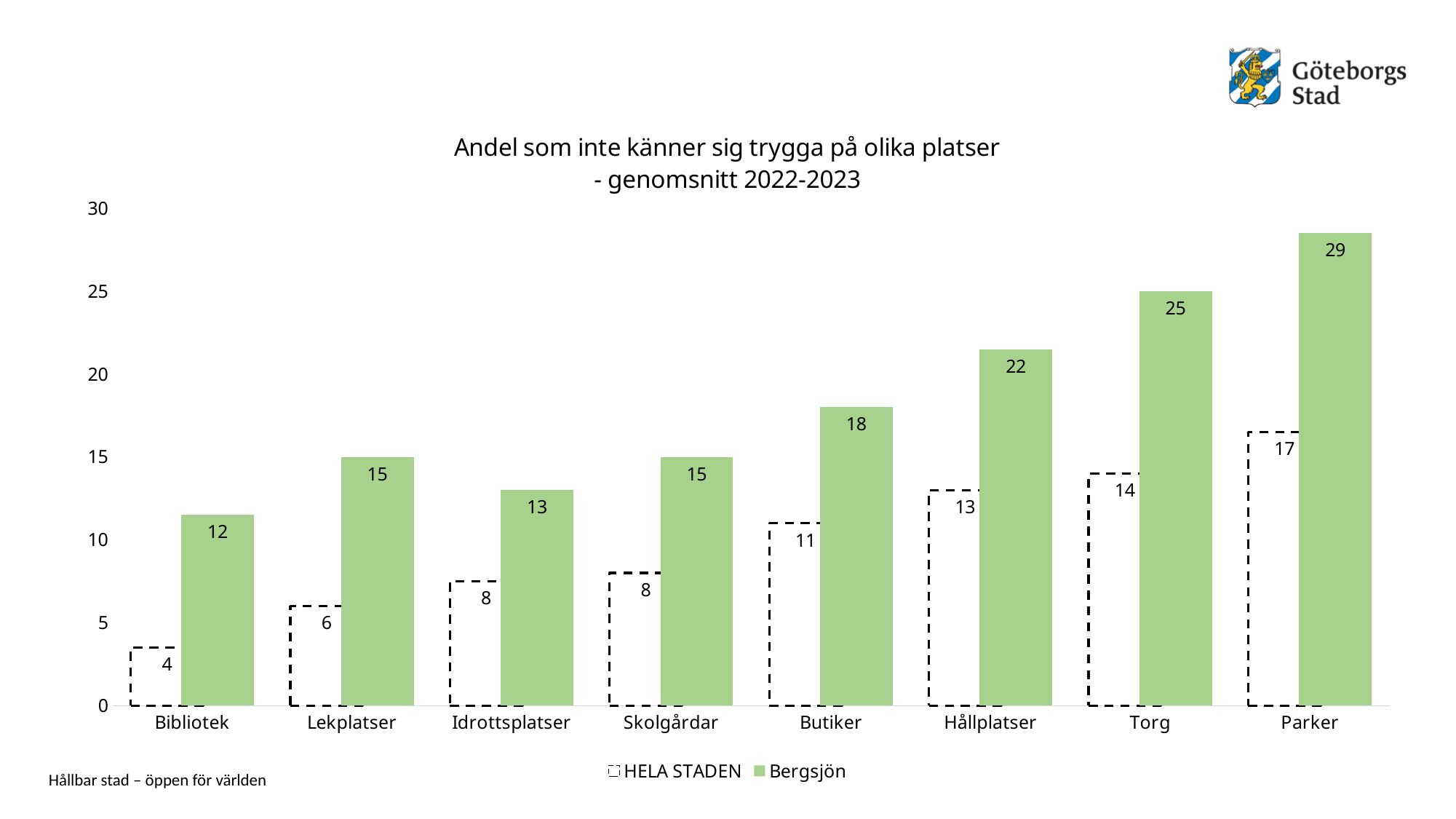
How many series does the legend list? 2 How many categories are shown on the x axis? 8 What is the title of the chart? Andel som inte känner sig trygga på olika platser - genomsnitt 2022-2023 What kind of chart is shown on the slide? bar chart Is the value for Bergsjön at Hållplatser greater or less than 20? greater What is the value for HELA STADEN at Bibliotek? 4 Which category has the lowest value for HELA STADEN? Bibliotek Which category has the highest value for Bergsjön? Parker What is the value for Bergsjön at Parker? 29 Which is larger at Hållplatser: the Bergsjön value or the HELA STADEN value? Bergsjön What is the difference between the Bergsjön and HELA STADEN values at Torg? 11 What is the value for Bergsjön at Butiker? 18